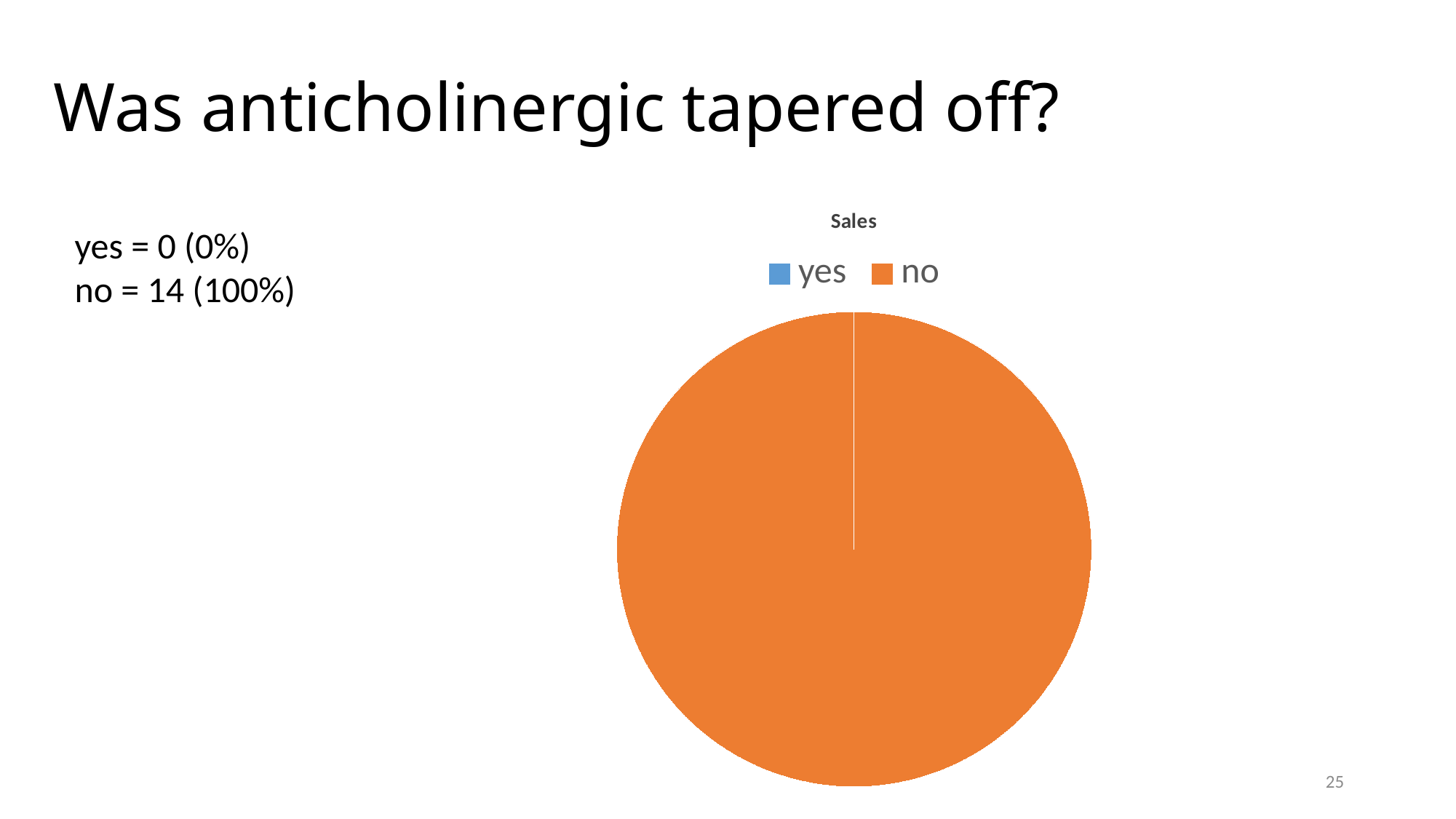
Which category takes up the smallest share of the pie? yes What share of the pie does the 'no' category represent? 100% How many entries does the chart legend list? 2 What colour is the 'no' slice of the pie? orange What share of the pie does the 'yes' category represent? 0% According to the slide, how many responses were 'no'? 14 According to the slide, how many responses were 'yes'? 0 Which is larger, the 'yes' slice or the 'no' slice? no What is the title of the chart? Sales What kind of chart is shown on the slide? pie chart What is the difference between the number of 'no' responses and 'yes' responses? 14 Which category takes up the largest share of the pie? no